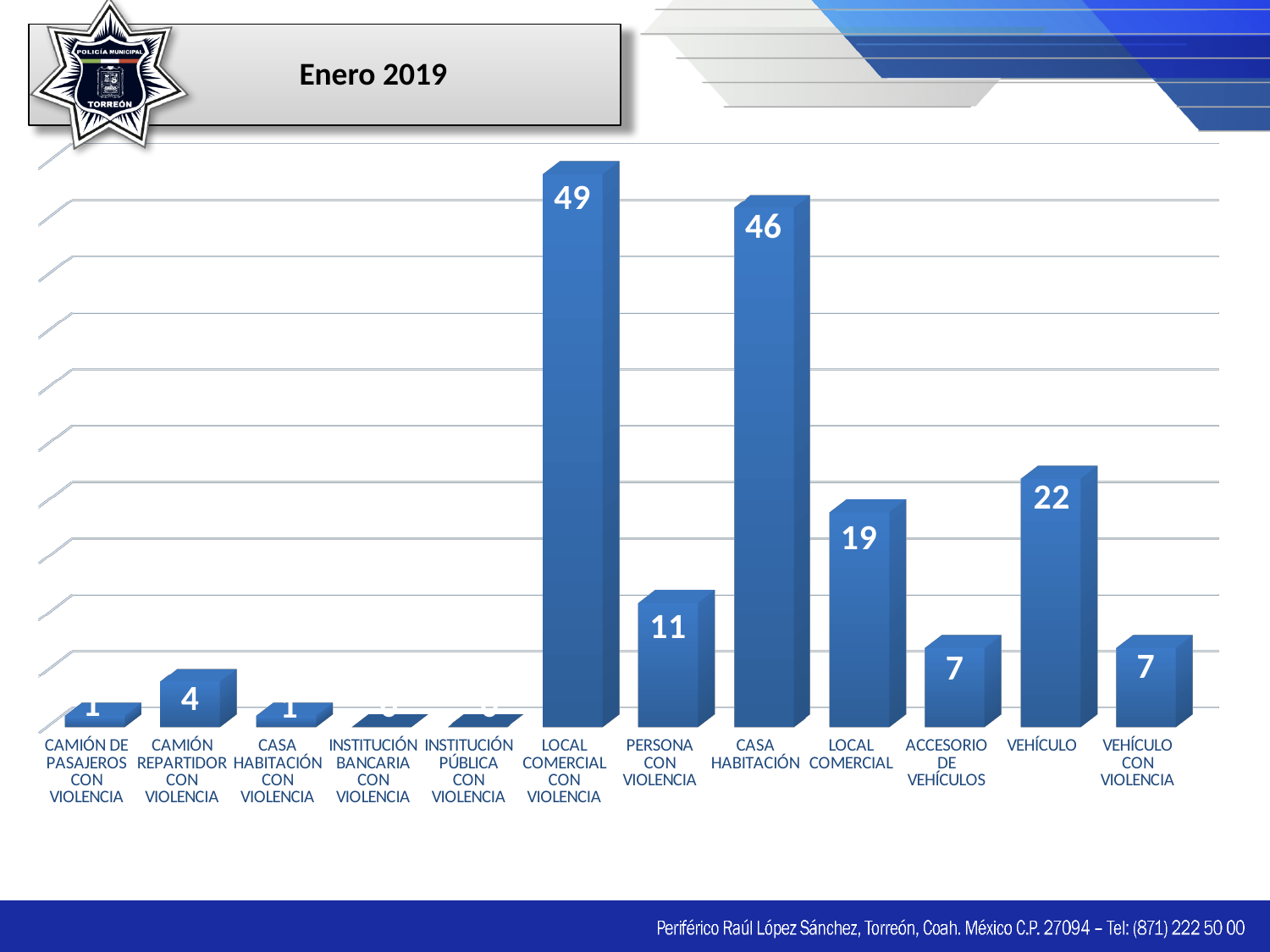
What is the value for CASA HABITACIÓN? 46 What is the difference between VEHÍCULO and LOCAL COMERCIAL? 3 What is the value for CAMIÓN REPARTIDOR CON VIOLENCIA? 4 What is the value for PERSONA CON VIOLENCIA? 11 What is the difference between LOCAL COMERCIAL CON VIOLENCIA and CASA HABITACIÓN? 3 Which category has the highest value? LOCAL COMERCIAL CON VIOLENCIA What is the value for LOCAL COMERCIAL CON VIOLENCIA? 49 How many categories are shown on the x axis? 12 What kind of chart is shown on the slide? bar chart What is the value for VEHÍCULO? 22 Which is larger, LOCAL COMERCIAL or PERSONA CON VIOLENCIA? LOCAL COMERCIAL What is the title shown in the box at the top of the slide? Enero 2019